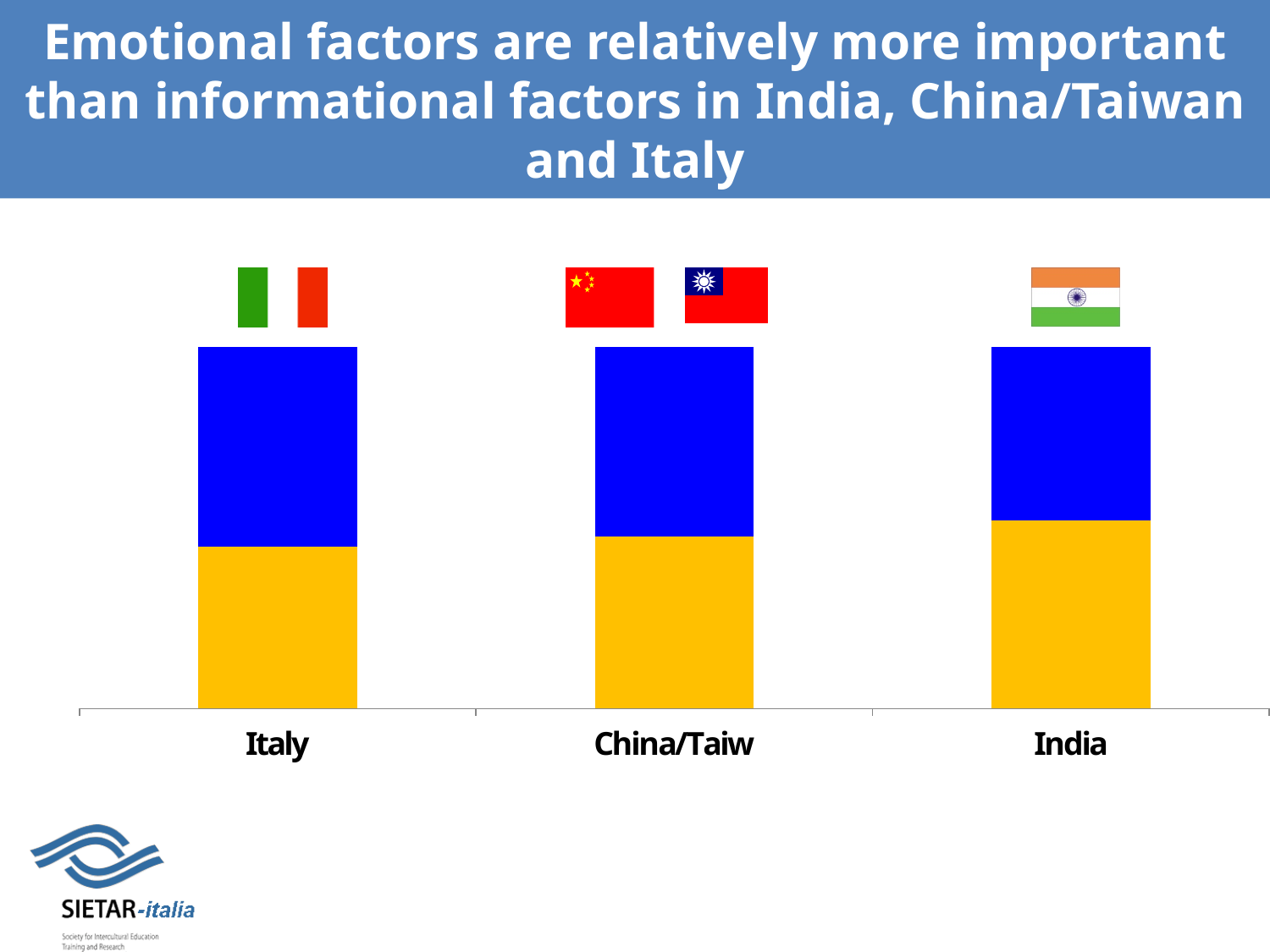
Which category has the shortest blue (top) segment in the chart? India What kind of chart is shown on the slide? Stacked bar chart Which category has the tallest yellow (bottom) segment in the chart? India What are the category labels along the x axis of the chart? Italy, China/Taiw, India How many categories (countries/regions) are shown on the x axis of the chart? 3 Does the yellow (bottom) segment rise or fall moving from Italy to India along the x axis? Rise What is the title of the slide containing the chart? Emotional factors are relatively more important than informational factors in India, China/Taiwan and Italy Which category has the shortest yellow (bottom) segment in the chart? Italy How many coloured segments make up each stacked bar in the chart? 2 Which category has the tallest blue (top) segment in the chart? Italy Is the yellow segment larger for Italy or for India? India Is the blue segment larger for Italy or for India? Italy